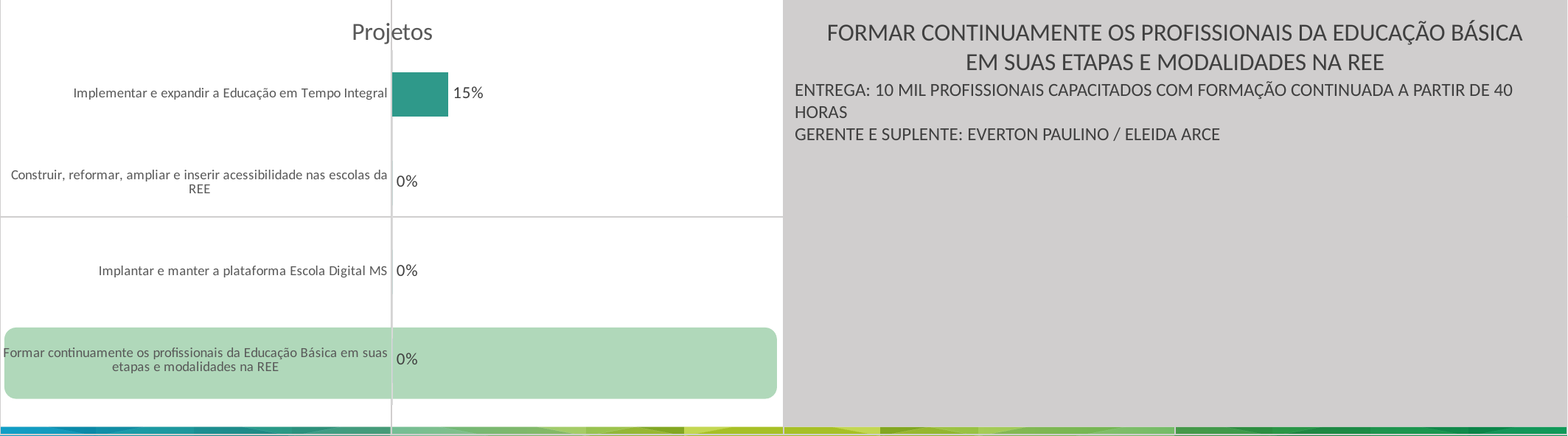
How many categories are shown in the chart? 4 How many categories in the chart have a value of 0%? 3 What is the value for "Construir, reformar, ampliar e inserir acessibilidade nas escolas da REE"? 0% What is the difference between the value for "Implementar e expandir a Educação em Tempo Integral" and the value for "Implantar e manter a plataforma Escola Digital MS"? 15% What is the title of the chart? Projetos Which is larger: the value for "Implementar e expandir a Educação em Tempo Integral" or the value for "Construir, reformar, ampliar e inserir acessibilidade nas escolas da REE"? Implementar e expandir a Educação em Tempo Integral What is the value for "Formar continuamente os profissionais da Educação Básica em suas etapas e modalidades na REE"? 0% What kind of chart is shown on the slide? Bar chart What is the value for "Implantar e manter a plataforma Escola Digital MS"? 0% What is the value for "Implementar e expandir a Educação em Tempo Integral"? 15% Which category has the highest value in the chart? Implementar e expandir a Educação em Tempo Integral Which category row in the chart is highlighted with a green background? Formar continuamente os profissionais da Educação Básica em suas etapas e modalidades na REE